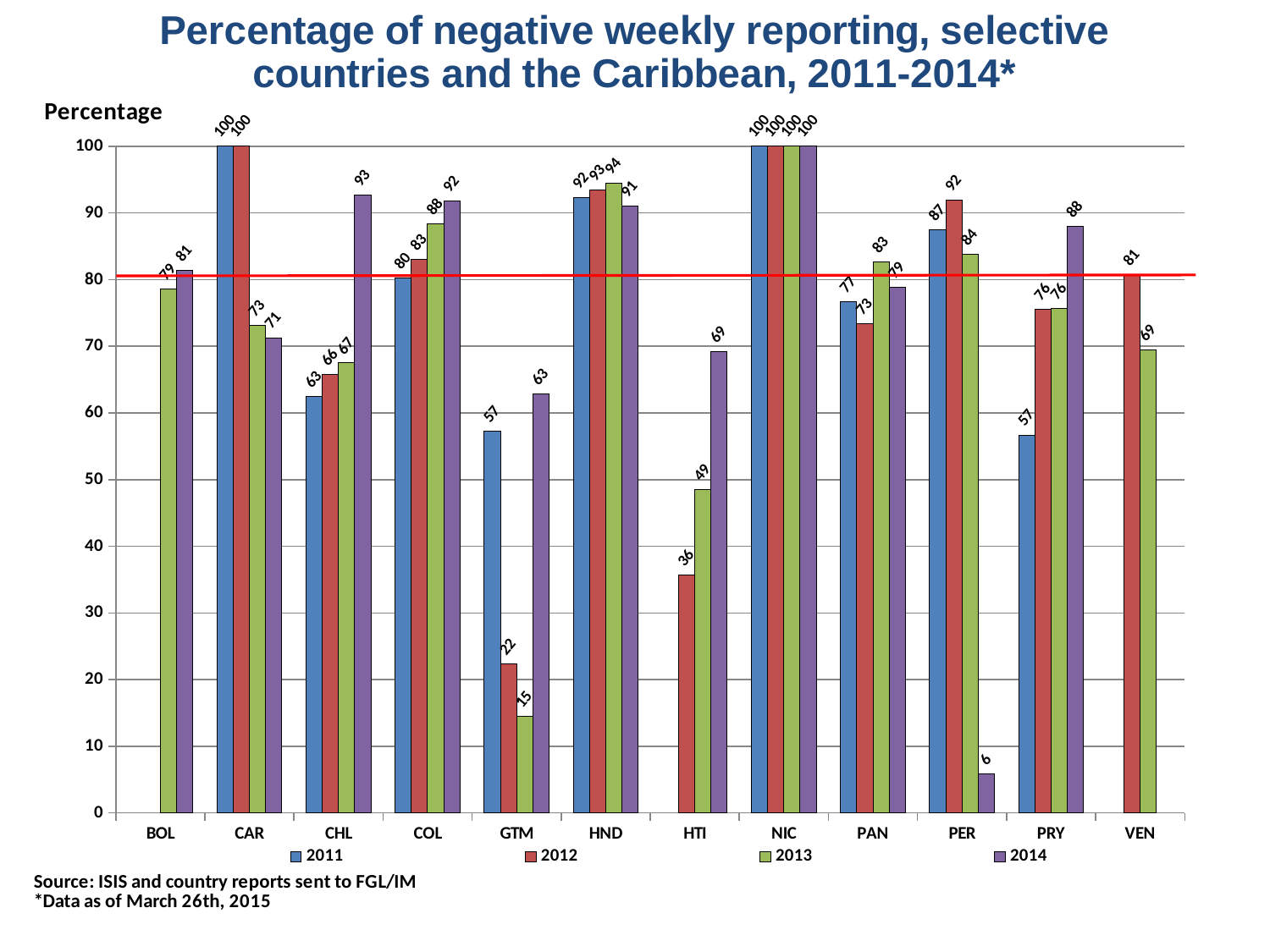
What are the four series listed in the legend? 2011, 2012, 2013, 2014 Which is larger, the 2014 value for HTI or the 2014 value for PAN? PAN What kind of chart is shown on the slide? bar chart Do the values for COL rise or fall from 2011 to 2014? rise What is the 2013 value for GTM? 15 How many series does the legend list? 4 Which country has the highest 2013 value? NIC What is the 2014 value for CHL? 93 Which country has the lowest 2014 value? PER How many countries/categories are shown on the x axis? 12 What is the difference between the 2014 and 2013 values for GTM? 48 What is the 2014 value for PER? 6